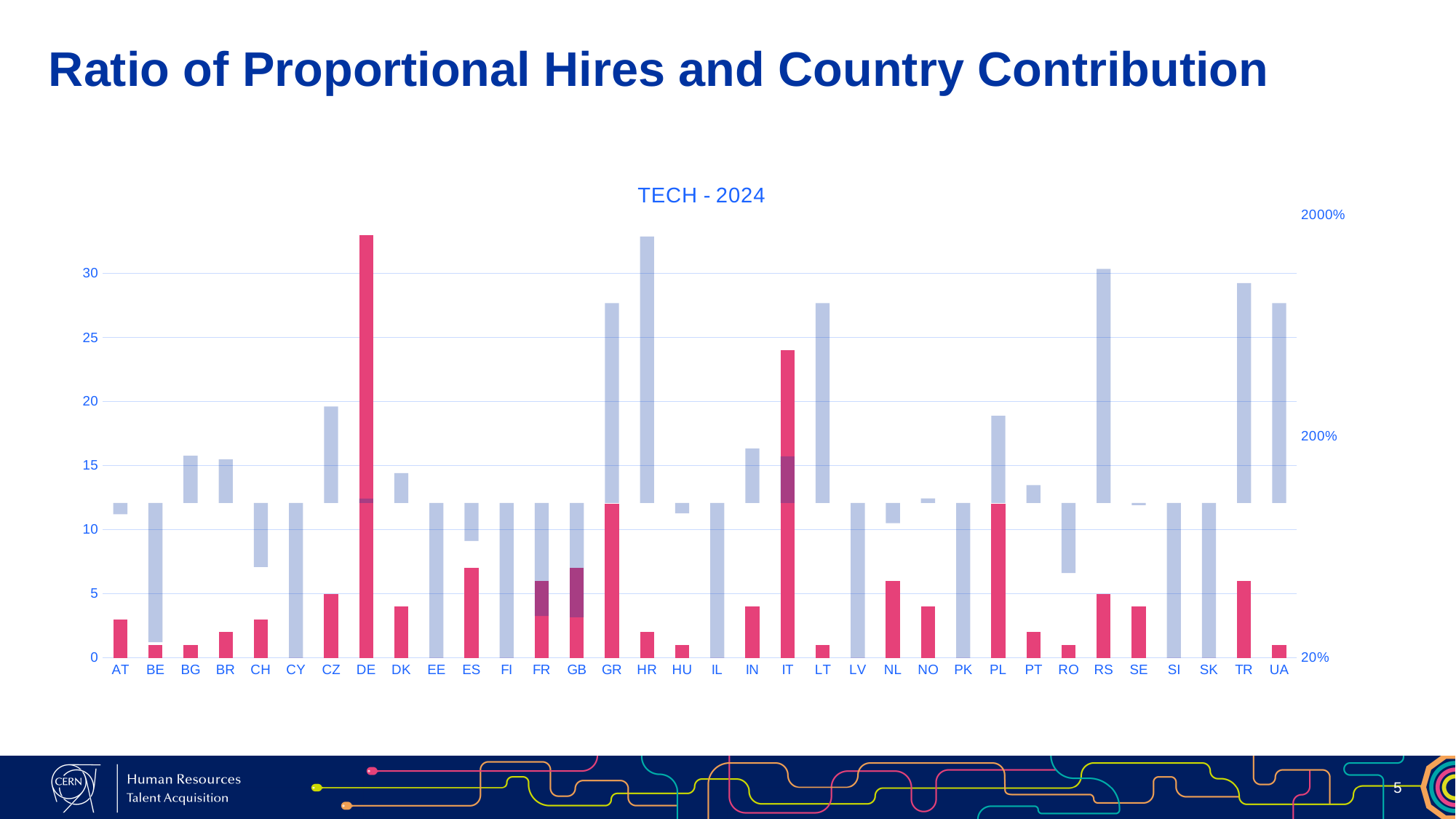
Which has the taller pink bar, PL or HR? PL What kind of chart is shown on the slide? bar chart Is the pink bar for DE greater or less than 30 on the left axis? greater Is the pink bar for ES greater or less than 10 on the left axis? less How many country categories are shown on the x axis? 34 Which country has the tallest pink bar? DE Is the pink bar for IT greater or less than 20 on the left axis? greater What is the title of the chart? TECH - 2024 Which country has the tallest light blue bar? HR Which has the taller pink bar, DE or IT? DE